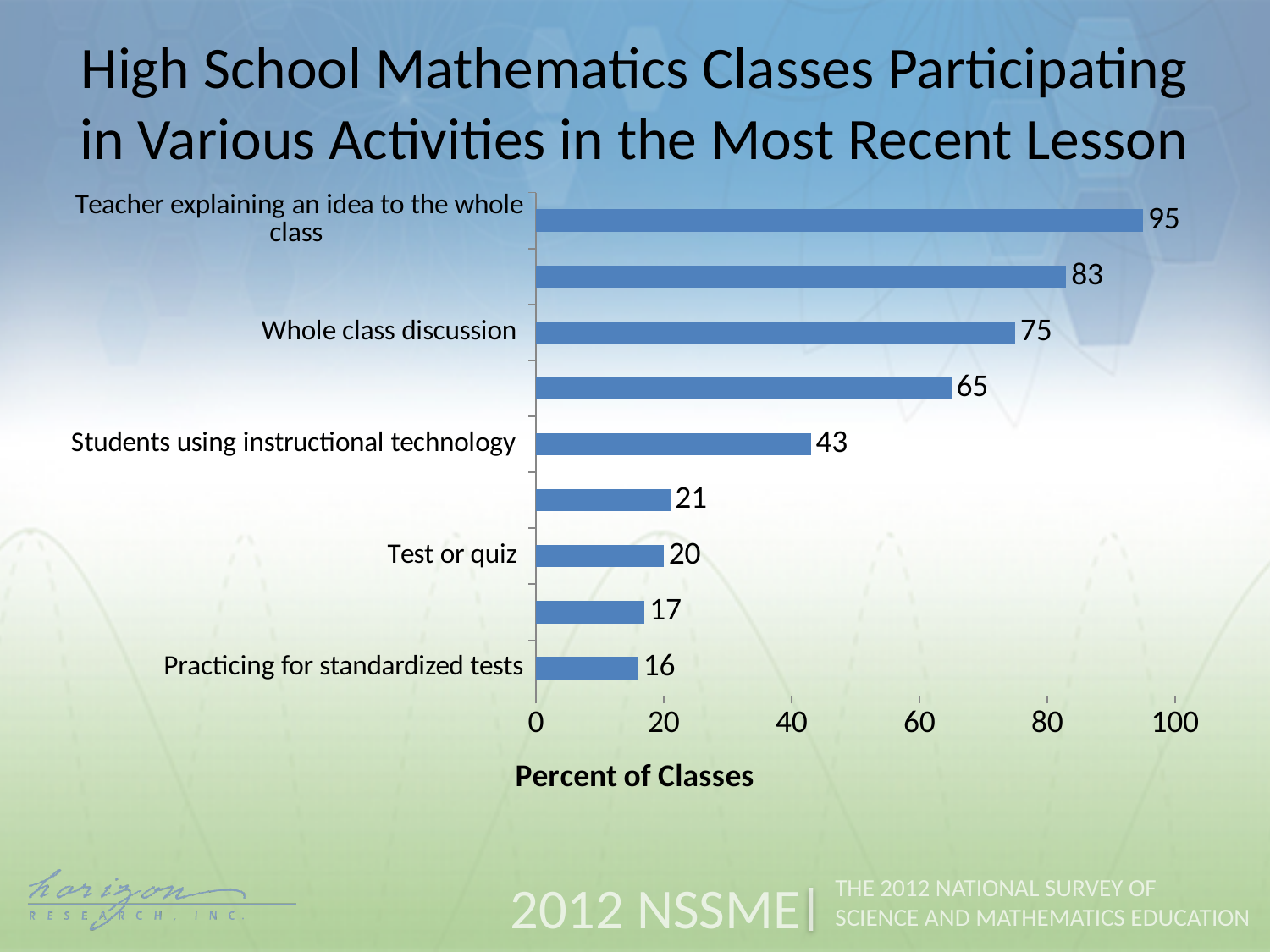
Which activity has the lowest percent of classes? Practicing for standardized tests What kind of chart is shown on the slide? Bar chart What is the value for "Test or quiz"? 20 What is the label of the horizontal axis? Percent of Classes Which activity has the highest percent of classes? Teacher explaining an idea to the whole class What is the value for "Practicing for standardized tests"? 16 How many bars are plotted in the chart? 9 What is the value for "Teacher explaining an idea to the whole class"? 95 Which is larger, the value for "Test or quiz" or the value for "Practicing for standardized tests"? Test or quiz What is the value for "Whole class discussion"? 75 What is the value for "Students using instructional technology"? 43 What is the difference between the values for "Whole class discussion" and "Students using instructional technology"? 32